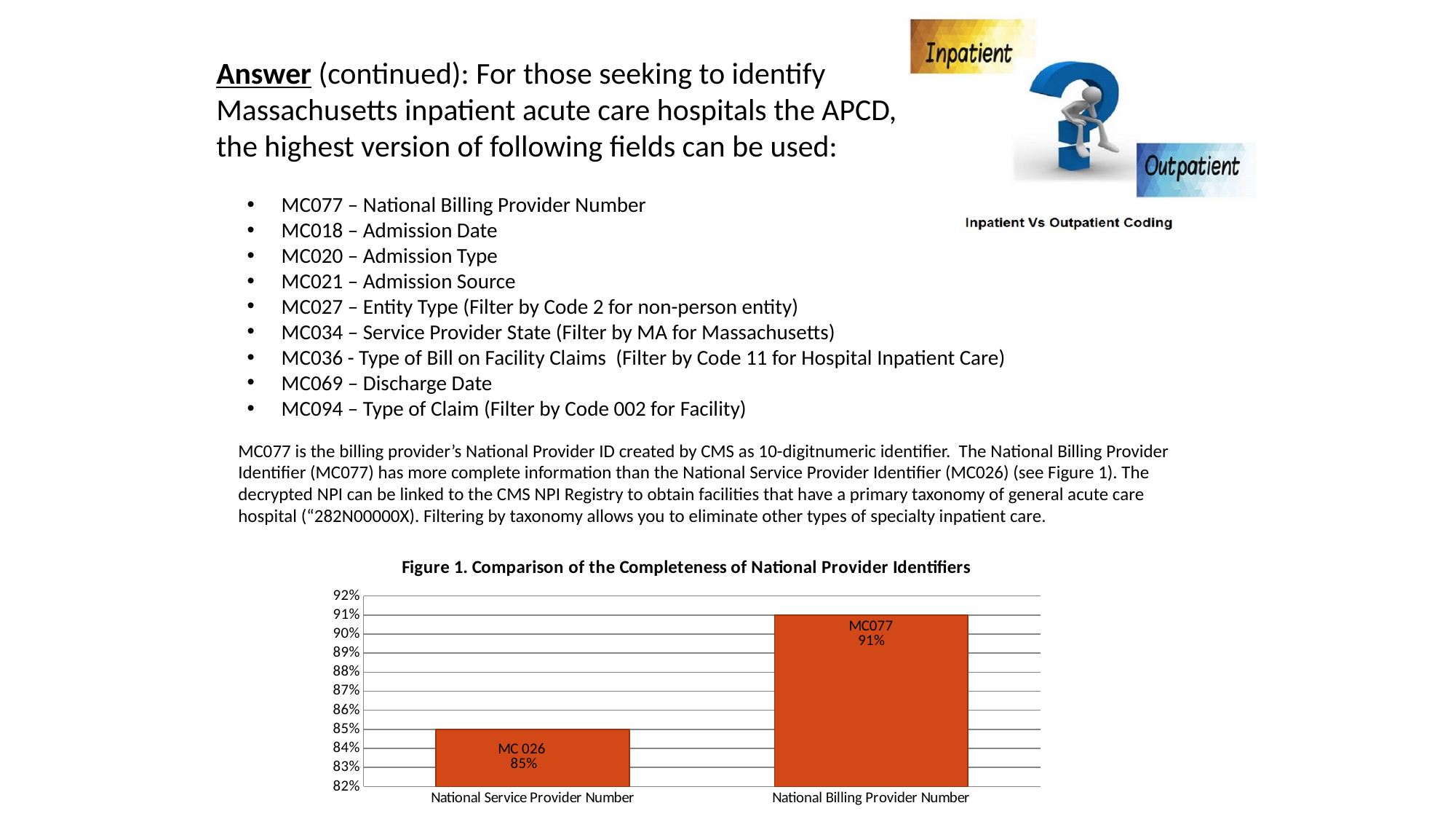
Which is larger, the value for National Service Provider Number or the value for National Billing Provider Number? National Billing Provider Number What is the value for National Billing Provider Number? 91% Which category has the lowest value? National Service Provider Number Which category has the highest value? National Billing Provider Number Is the value for National Service Provider Number greater or less than 88%? less What is the value for National Service Provider Number? 85% How many categories are shown in the chart? 2 Is the value for National Billing Provider Number greater or less than 90%? greater What is the difference between the values for National Billing Provider Number and National Service Provider Number? 6% What kind of chart is shown on the slide? Bar chart What is the title of the chart? Figure 1. Comparison of the Completeness of National Provider Identifiers Which field code is labelled on the bar for National Billing Provider Number? MC077